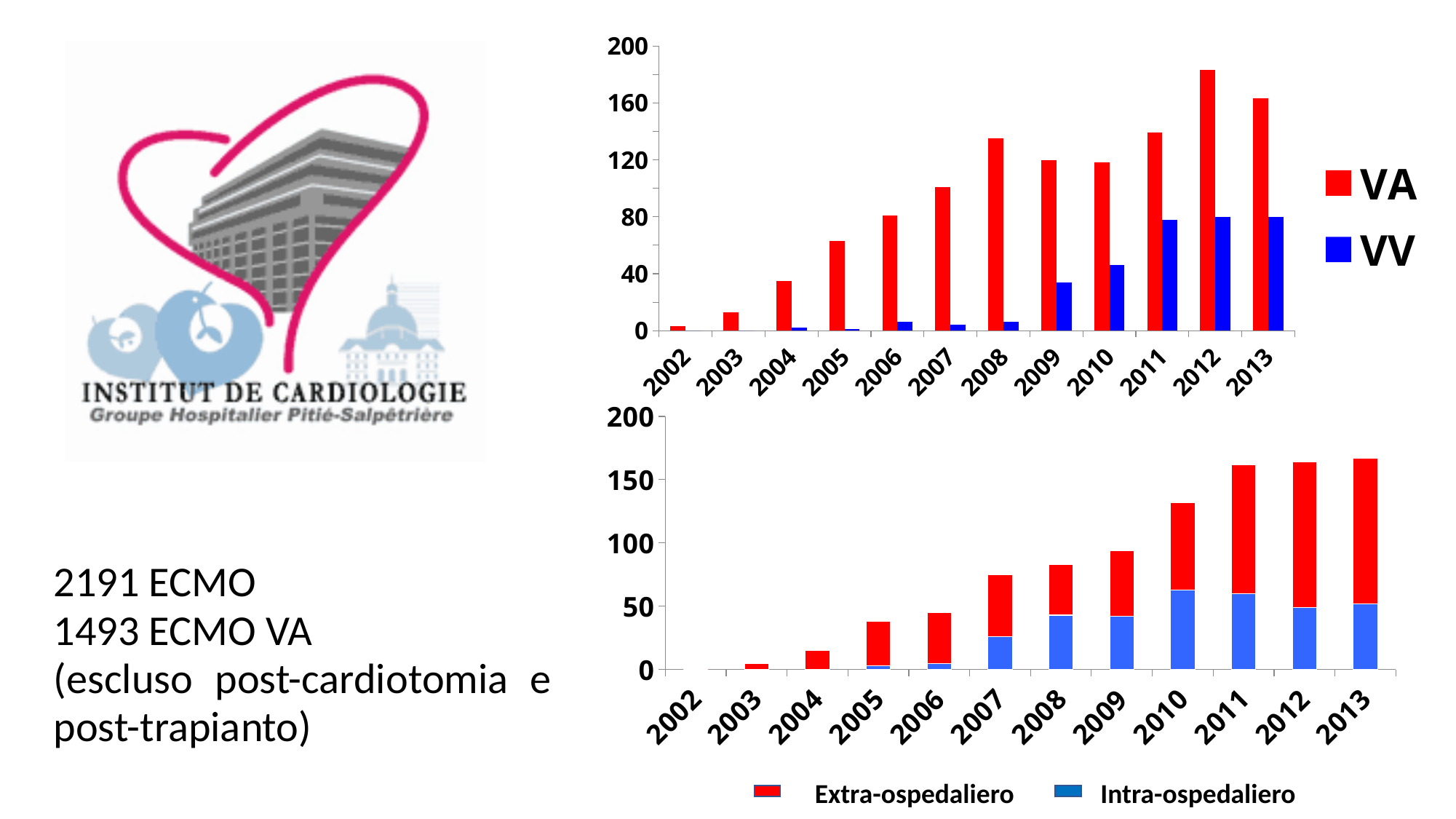
In the top chart, which is larger in 2010, VA or VV? VA In the top chart, is the VA value for 2008 greater or less than 120? greater In the bottom chart, is the Intra-ospedaliero value for 2010 greater or less than 50? greater In the bottom chart, what are the two legend entries? Extra-ospedaliero and Intra-ospedaliero In the top chart, which year has the highest VA value? 2012 In the top chart, is the VV value for 2010 greater or less than 40? greater In the top chart, how many years are shown on the x axis? 12 In the bottom chart, do the stacked bar totals generally rise or fall from 2002 to 2013? rise In the top chart, how many series does the legend list? 2 In the top chart, what kind of chart is shown? bar chart